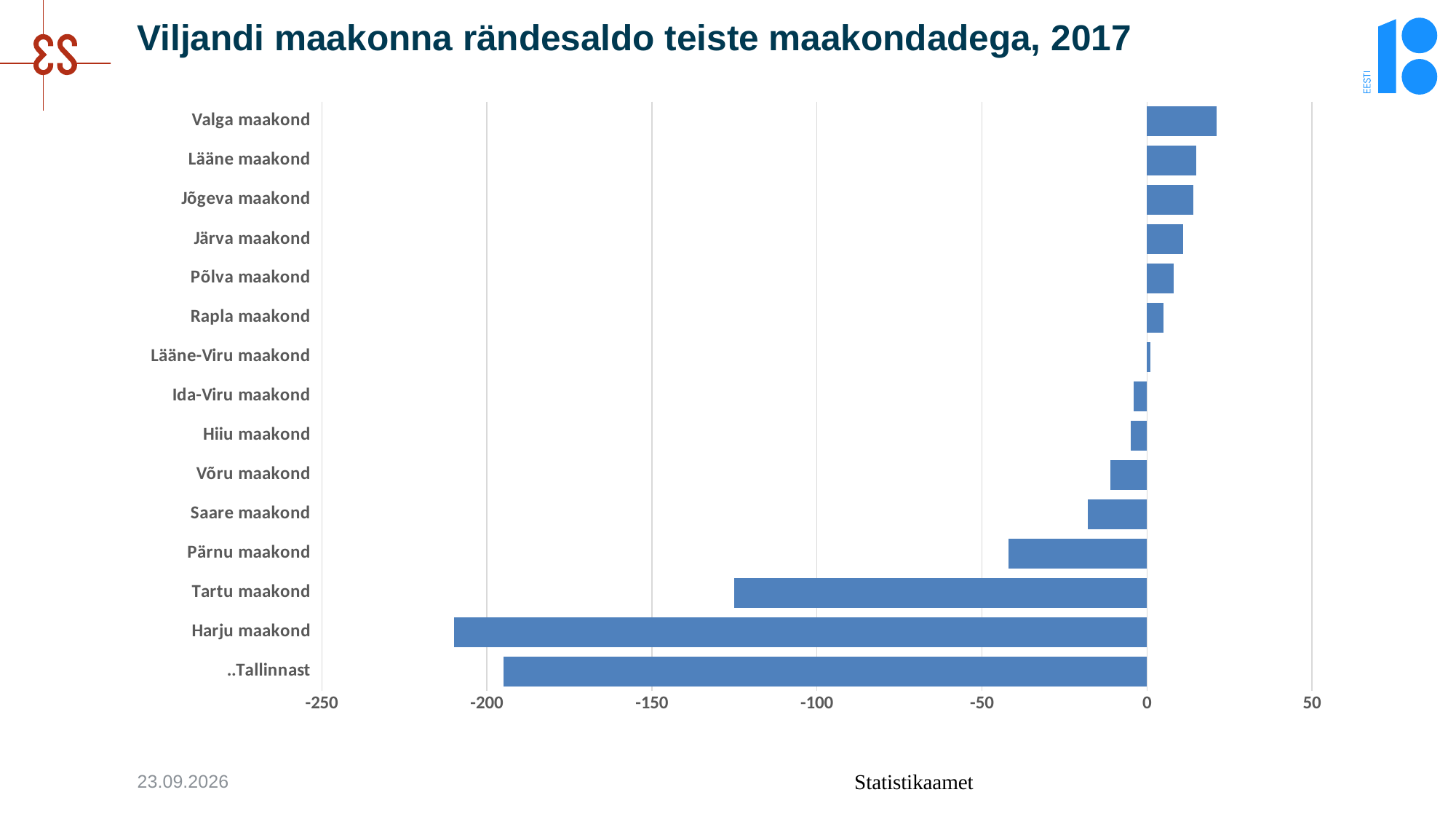
What is the title of the chart? Viljandi maakonna rändesaldo teiste maakondadega, 2017 Is the value for Tartu maakond greater or less than -100? less Is the value for ..Tallinnast greater or less than -150? less Which category has the lowest (most negative) value? Harju maakond How many categories (bars) does the chart show? 15 Is the value for Harju maakond greater or less than -200? less What kind of chart is shown on the slide? bar chart Which category has the highest (most positive) value? Valga maakond Which has the larger value, Harju maakond or ..Tallinnast? ..Tallinnast Which has the larger value, Tartu maakond or Pärnu maakond? Pärnu maakond